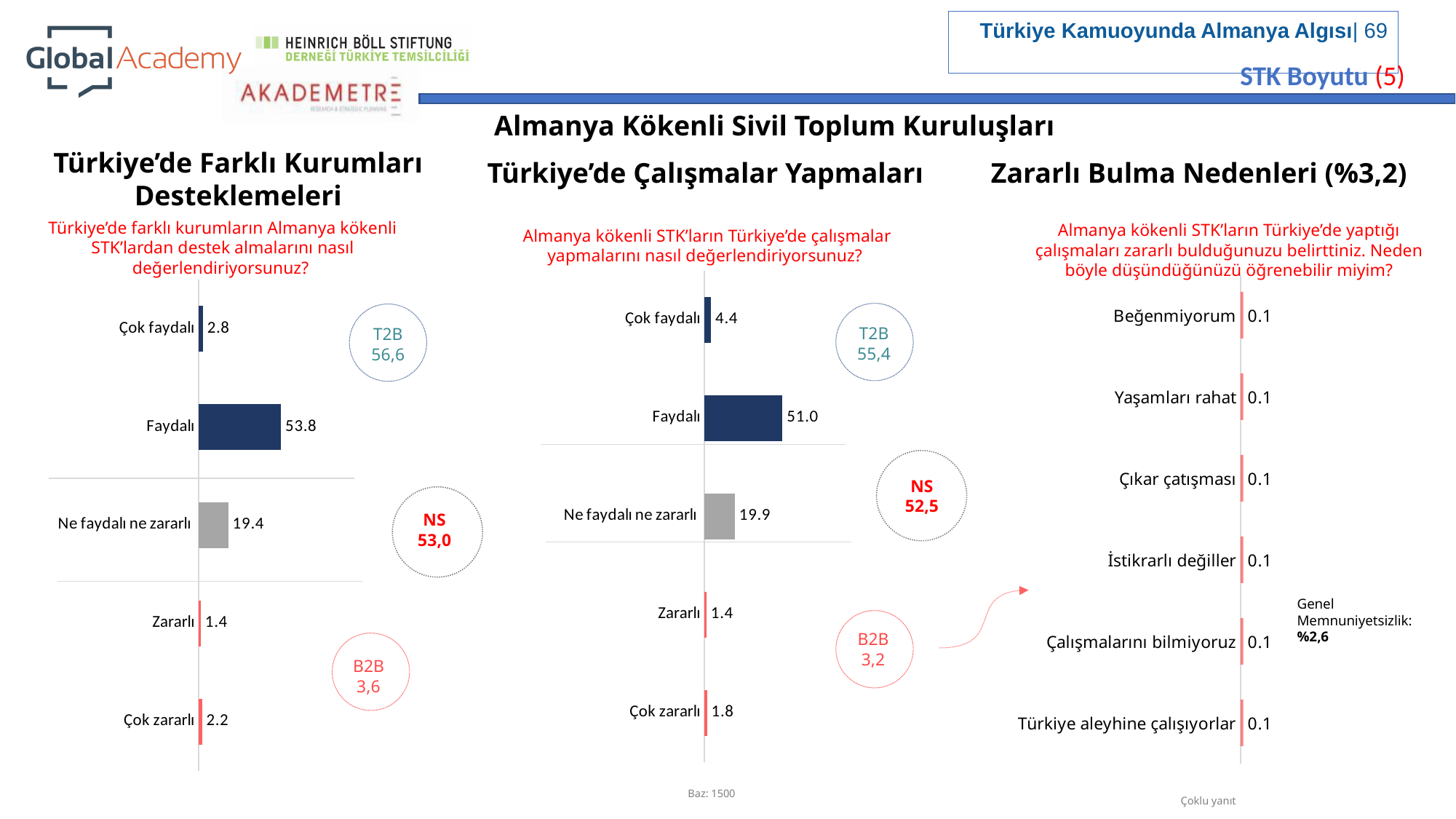
In the right chart 'Zararlı Bulma Nedenleri (%3,2)', how many categories are plotted? 6 In the middle chart 'Türkiye'de Çalışmalar Yapmaları', what T2B value is shown in the circle? 55,4 In the left chart 'Türkiye'de Farklı Kurumları Desteklemeleri', which category has the lowest value? Zararlı What kind of chart is the middle chart 'Türkiye'de Çalışmalar Yapmaları'? Bar chart In the middle chart 'Türkiye'de Çalışmalar Yapmaları', which is larger: Zararlı or Çok zararlı? Çok zararlı In the left chart 'Türkiye'de Farklı Kurumları Desteklemeleri', what is the value for Faydalı? 53.8 In the middle chart 'Türkiye'de Çalışmalar Yapmaları', which category has the highest value? Faydalı In the left chart 'Türkiye'de Farklı Kurumları Desteklemeleri', what is the difference between Faydalı and Ne faydalı ne zararlı? 34.4 In the right chart 'Zararlı Bulma Nedenleri (%3,2)', what is the value for Çalışmalarını bilmiyoruz? 0.1 In the left chart 'Türkiye'de Farklı Kurumları Desteklemeleri', how many categories are plotted? 5 In the middle chart 'Türkiye'de Çalışmalar Yapmaları', what is the difference between Ne faydalı ne zararlı and Çok faydalı? 15.5 In the middle chart 'Türkiye'de Çalışmalar Yapmaları', what is the value for Çok faydalı? 4.4